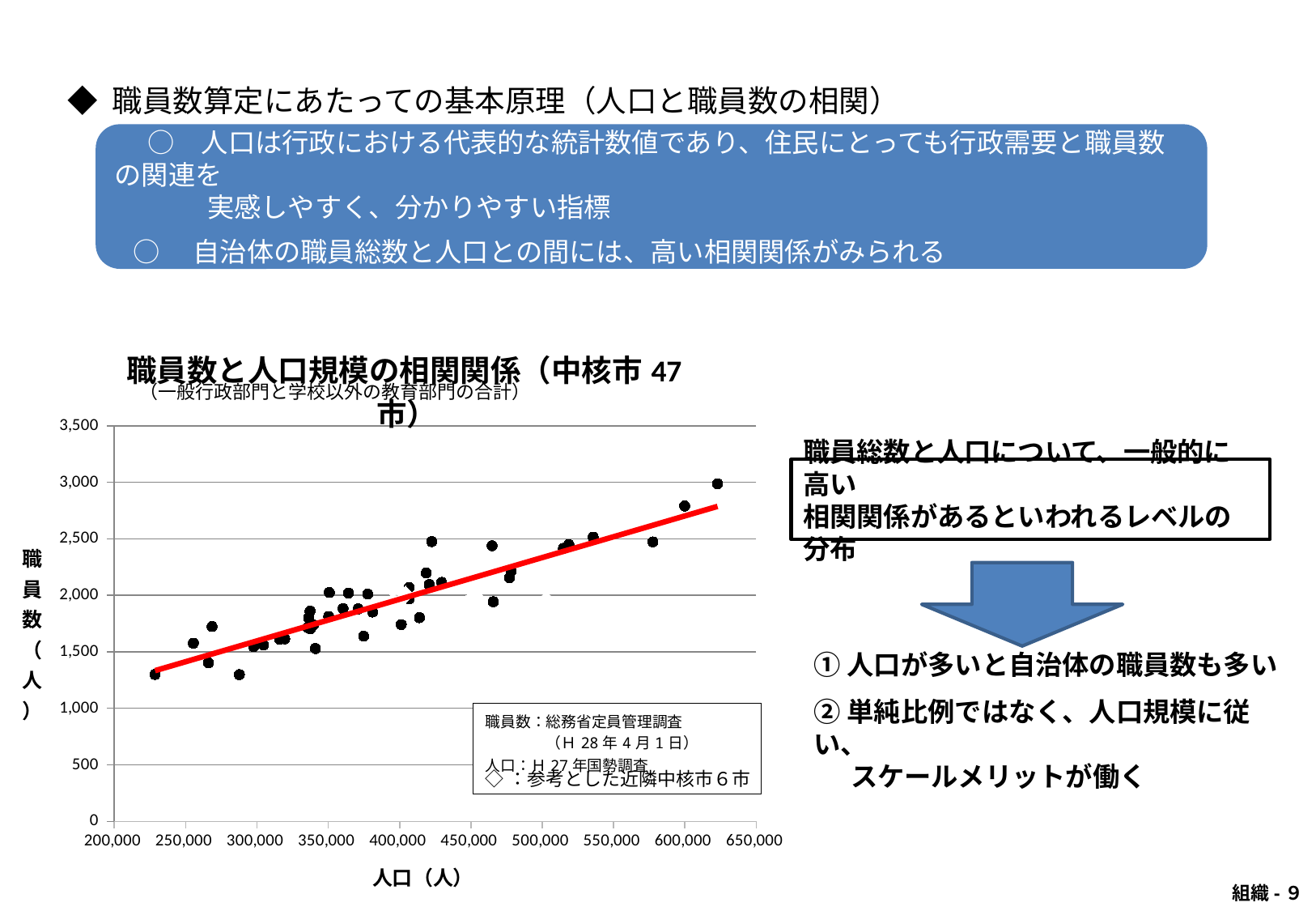
Is the staff number for the city with a population of about 600,000 greater or less than 2,500? greater Is the staff number for the city with the smallest population (around 230,000) greater or less than 1,500? less As population increases along the x axis, do the staff numbers generally rise or fall? rise What is the lowest population value shown on the horizontal axis? 200,000 Is the staff number for the city with a population of about 290,000 greater or less than 1,500? less What is the label of the horizontal axis of the chart? 人口（人） What kind of chart is shown on the slide? scatter chart What is the title of the chart? 職員数と人口規模の相関関係（中核市47市） According to the chart title, how many core cities (中核市) are plotted? 47 What is the highest value shown on the vertical axis of the chart? 3,500 What is the highest population value shown on the horizontal axis? 650,000